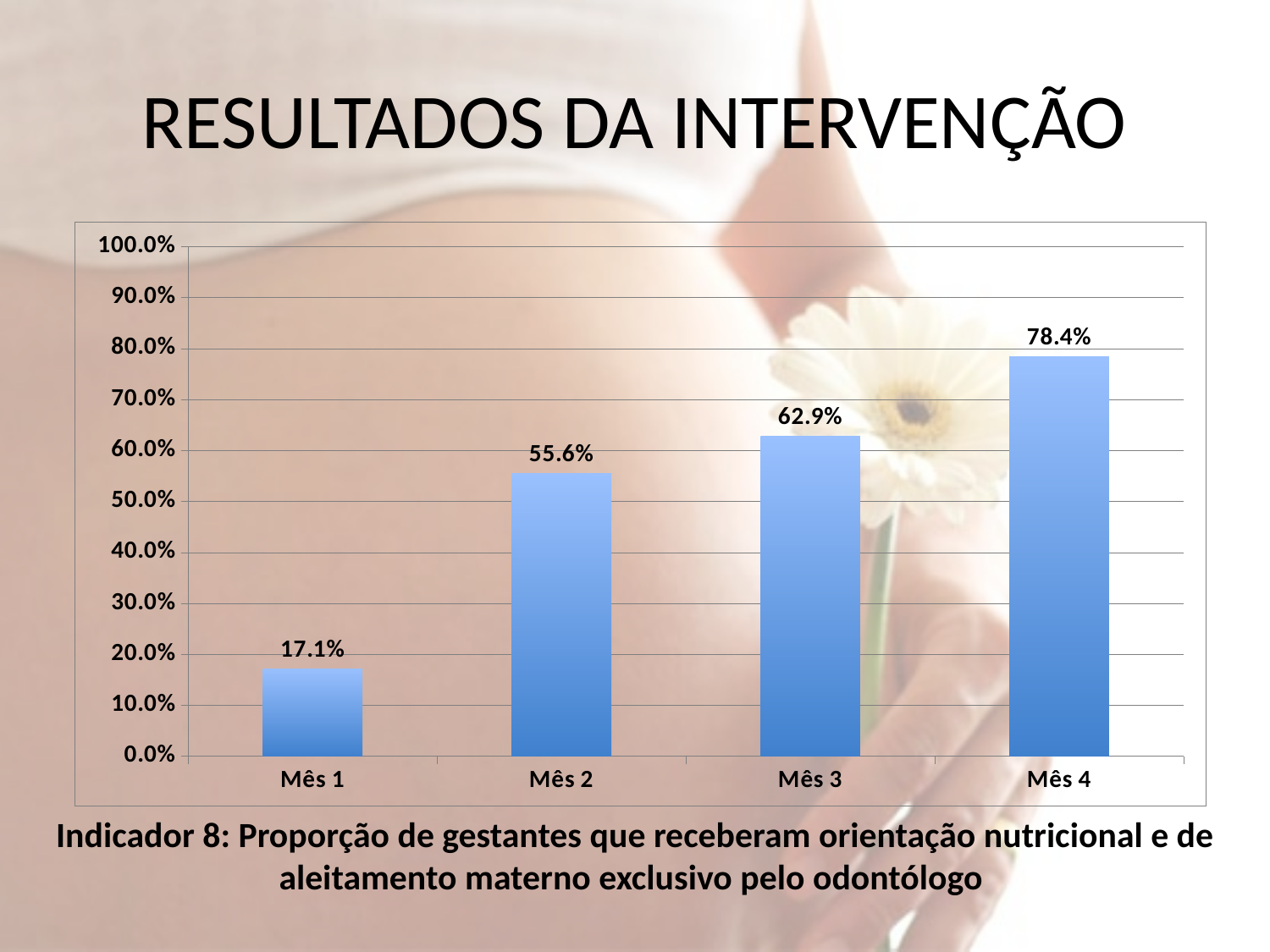
Which is larger, the value for Mês 2 or the value for Mês 3? Mês 3 What is the value for Mês 2? 55.6% What is the value for Mês 3? 62.9% What kind of chart is shown on the slide? Bar chart What is the value for Mês 1? 17.1% Do the values rise or fall from Mês 1 to Mês 4? Rise What is the difference between the values for Mês 4 and Mês 1? 61.3% What is the value for Mês 4? 78.4% How many months are shown on the x axis? 4 Which month has the highest value? Mês 4 What is the difference between the values for Mês 3 and Mês 2? 7.3% Which month has the lowest value? Mês 1